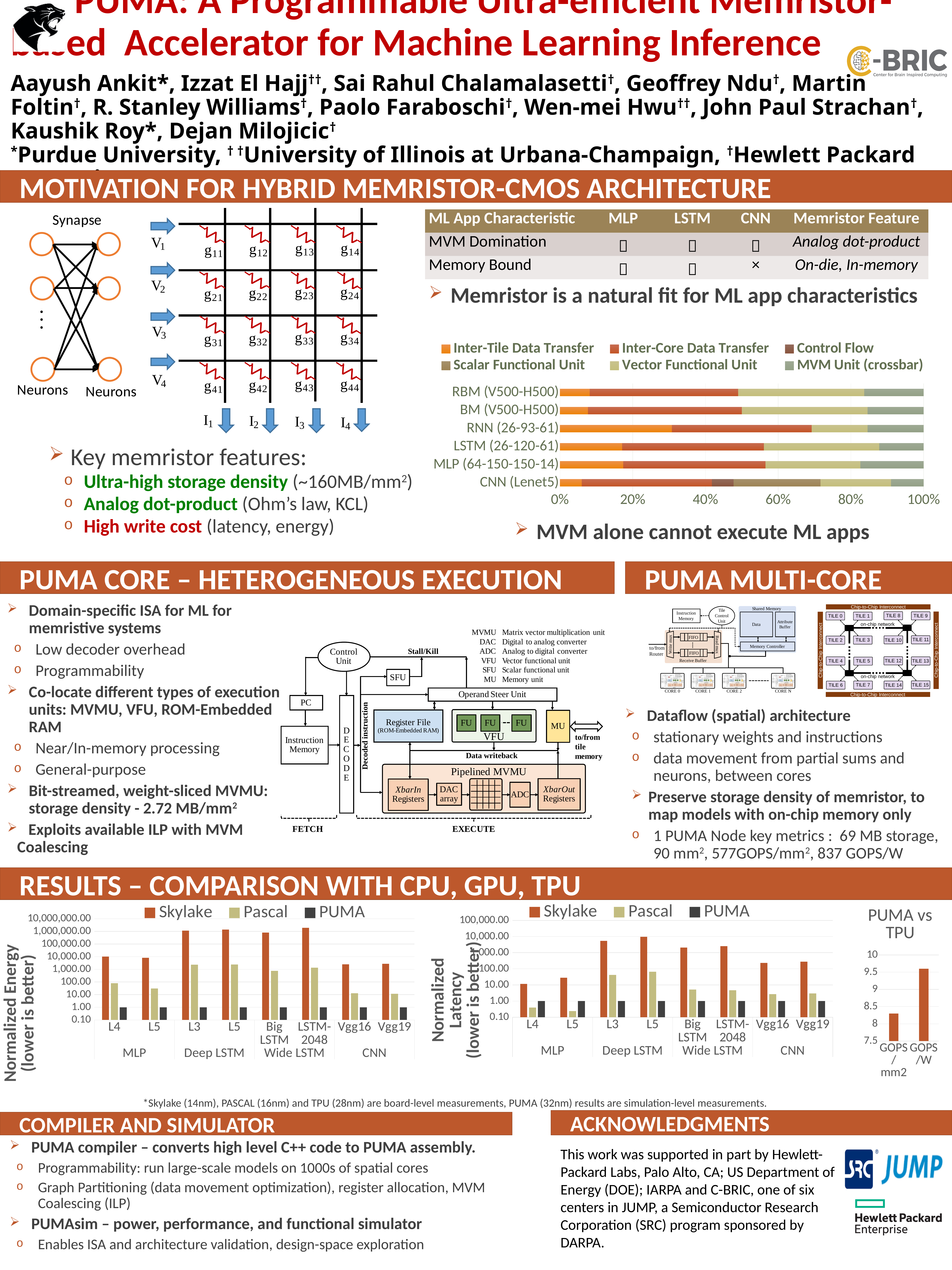
In the Normalized Energy chart, which is larger for L3 (Deep LSTM): Skylake or PUMA? Skylake In the PUMA vs TPU chart, is the GOPS/mm2 value greater or less than 8.5? less In the PUMA vs TPU chart, which of the two bars is larger: GOPS/mm2 or GOPS/W? GOPS/W In the stacked bar chart in the Motivation section, which series is listed last in the legend? MVM Unit (crossbar) In the Normalized Energy chart, is the Skylake value for L4 greater or less than 1,000? greater In the Normalized Energy chart, how many series does the legend list? 3 In the Normalized Latency chart, is the Skylake value for L4 greater or less than 100? less In the Normalized Energy chart, how many workload categories are plotted along the x axis? 8 In the Normalized Latency chart, which category has the highest Skylake latency? L5 (Deep LSTM) In the stacked bar chart in the Motivation section, how many series does the legend list? 6 What kind of chart is the one in the Motivation section showing Inter-Tile Data Transfer and MVM Unit (crossbar)? bar chart In the stacked bar chart in the Motivation section, how many workload categories are plotted? 6